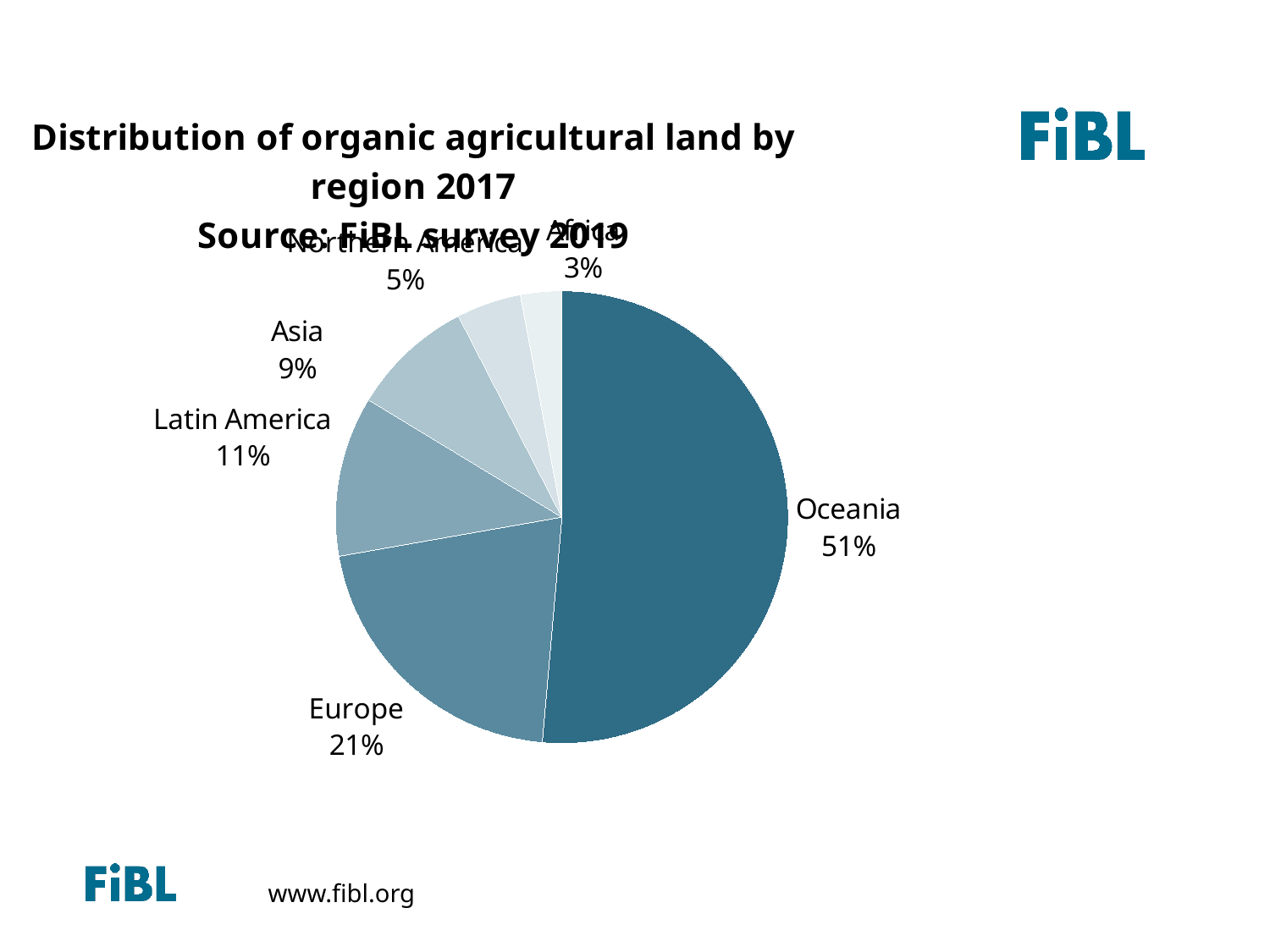
What kind of chart is shown on the slide? Pie chart Which region has the largest share of organic agricultural land? Oceania Which region has the smallest share of organic agricultural land? Africa What share of organic agricultural land does Africa hold? 3% What share of organic agricultural land does Asia hold? 9% What is the difference in percentage points between Oceania's share and Europe's share? 30 percentage points What year does the chart title say the distribution refers to? 2017 How many regions are shown in the pie chart? 6 What share of organic agricultural land does Latin America hold? 11% Which region has a larger share, Latin America or Asia? Latin America What share of organic agricultural land does Oceania hold? 51% What share of organic agricultural land does Europe hold? 21%